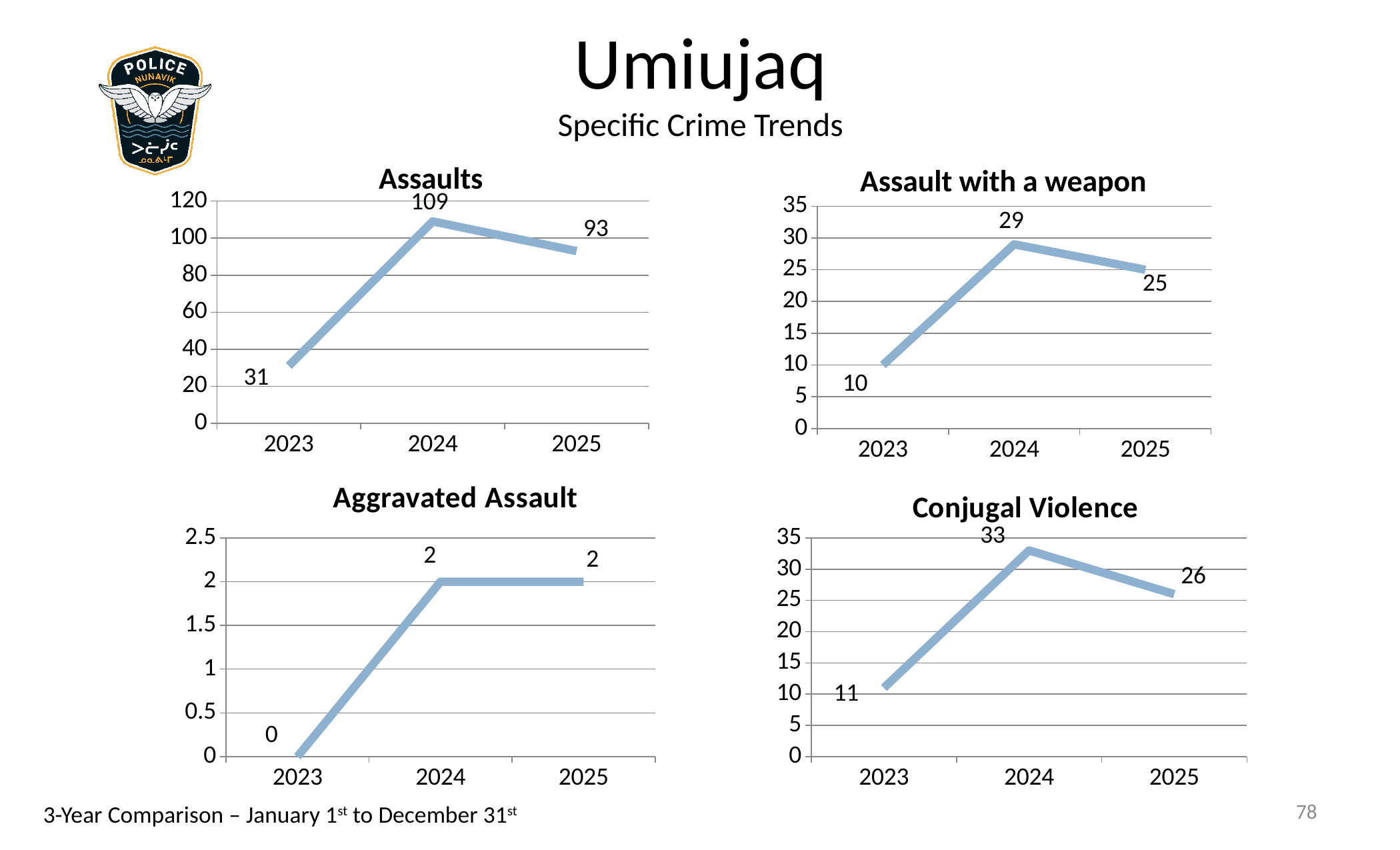
In the Conjugal Violence chart, which year has the lowest value? 2023 What kind of chart is the Assault with a weapon chart? Line chart In the Conjugal Violence chart, what is the value for 2023? 11 In the Assaults chart, what is the value for 2024? 109 In the Conjugal Violence chart, which is larger, the value for 2024 or the value for 2025? 2024 In the Assaults chart, what is the difference between the 2024 and 2023 values? 78 In the Assault with a weapon chart, what is the value for 2025? 25 In the Assaults chart, does the value rise or fall from 2024 to 2025? Fall In the Assaults chart, which year has the highest value? 2024 In the Assault with a weapon chart, what is the difference between the 2024 and 2025 values? 4 In the Aggravated Assault chart, what is the value for 2023? 0 How many data points are plotted in the Aggravated Assault chart? 3